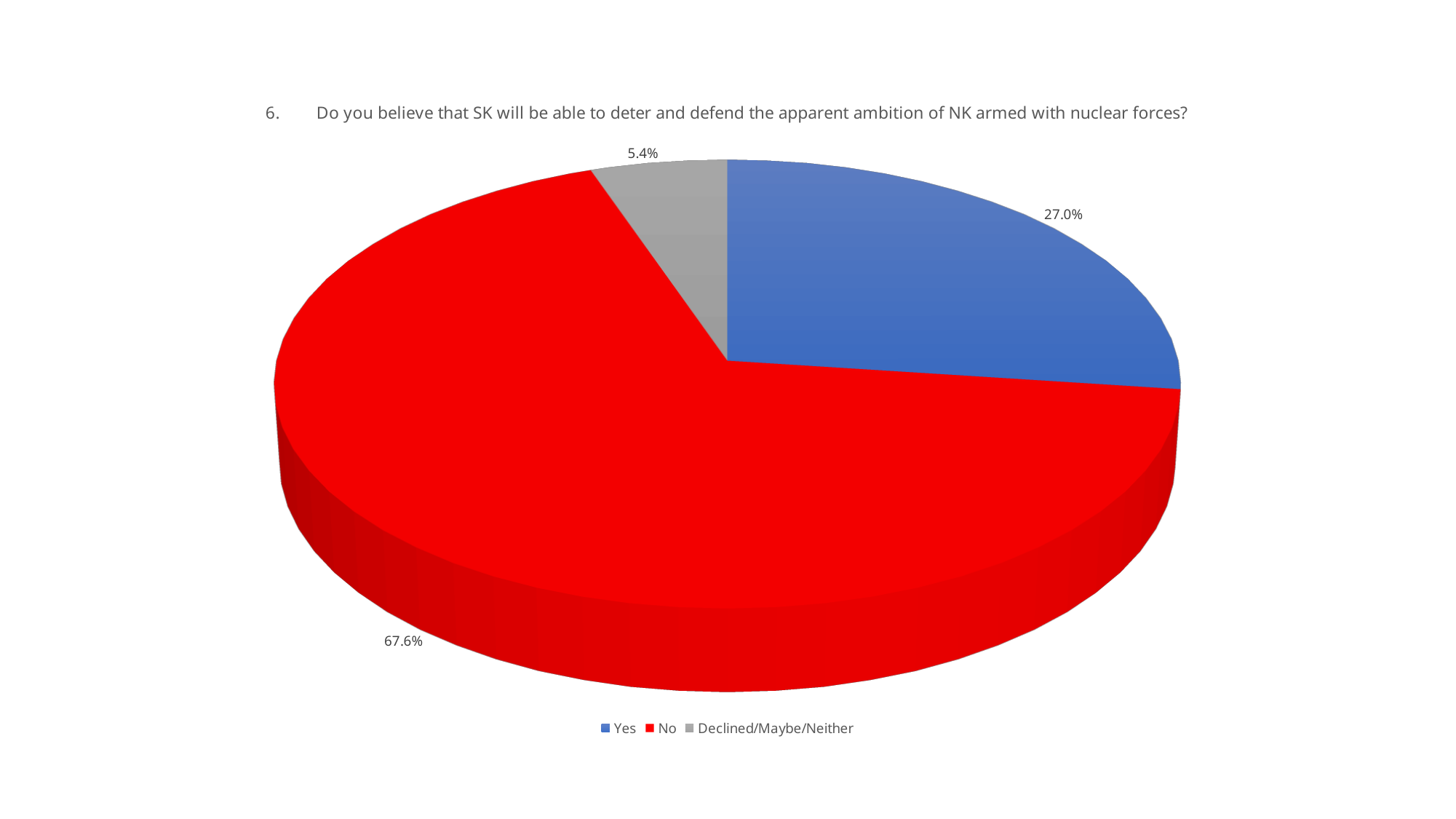
What percentage of respondents fall under "Declined/Maybe/Neither"? 5.4% What type of chart is shown on the slide? Pie chart What colour is the "No" slice? Red What percentage of respondents answered "Yes"? 27.0% What is the combined share of "Yes" and "Declined/Maybe/Neither"? 32.4% How many entries does the legend list? 3 Which response has the largest share of the pie? No Which response has the smallest share of the pie? Declined/Maybe/Neither What percentage of respondents answered "No"? 67.6% How many slices does the pie chart have? 3 What is the difference in percentage points between the "No" and "Yes" shares? 40.6 Which is larger, the share for "Yes" or the share for "Declined/Maybe/Neither"? Yes